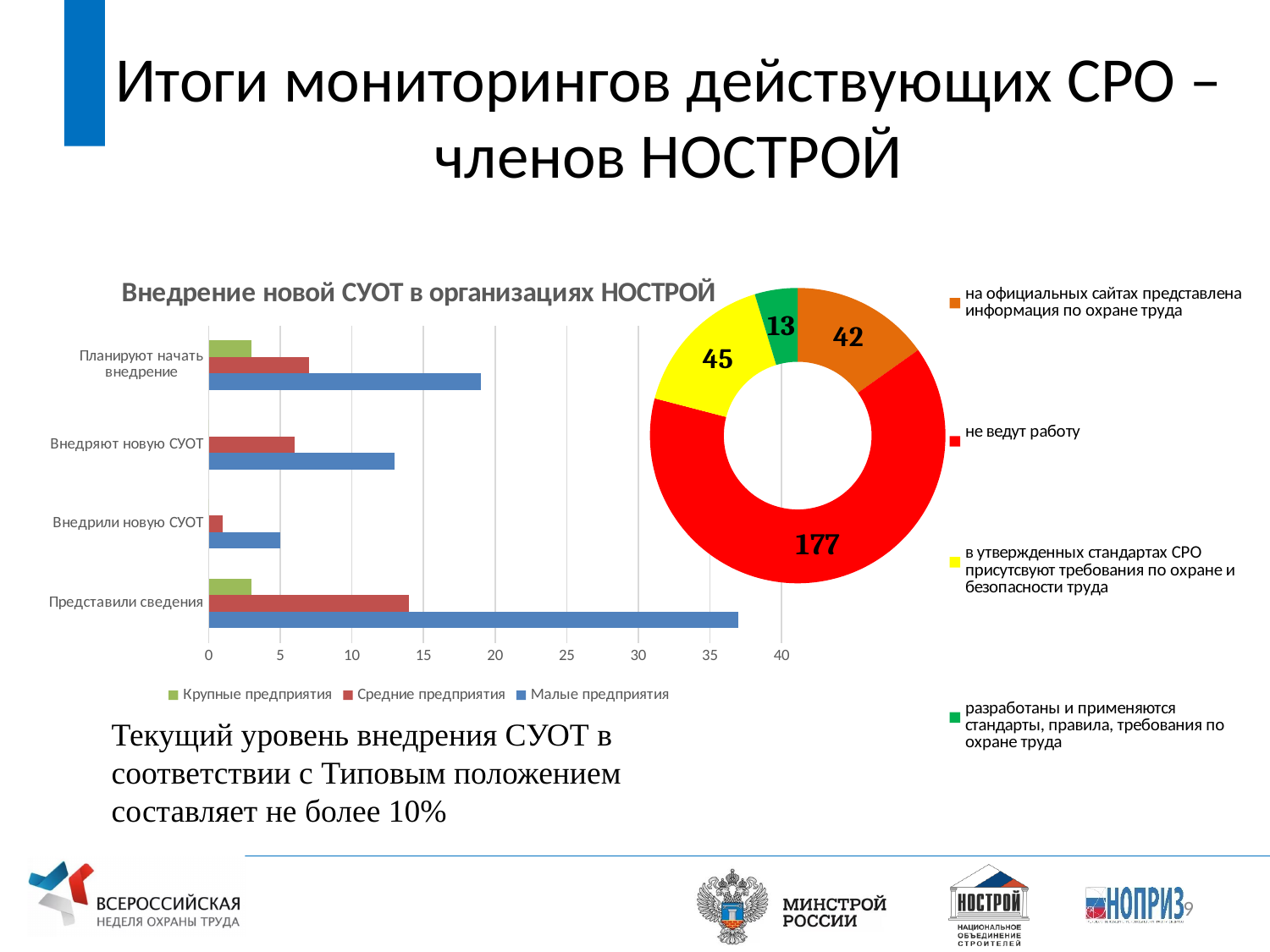
In the doughnut chart on the right, what is the difference between the value for "в утвержденных стандартах СРО присутсвуют требования по охране и безопасности труда" and the value for "на официальных сайтах представлена информация по охране труда"? 3 In the doughnut chart on the right, what is the total of all four segments? 277 In the doughnut chart on the right, what is the value for "не ведут работу"? 177 In the chart "Внедрение новой СУОТ в организациях НОСТРОЙ", which is larger for the category "Планируют начать внедрение": "Малые предприятия" or "Средние предприятия"? Малые предприятия What kind of chart is the chart on the right of the slide with the values 42, 177, 45 and 13? Doughnut chart In the chart "Внедрение новой СУОТ в организациях НОСТРОЙ", is the value for "Малые предприятия" in the category "Представили сведения" greater or less than 35? greater What kind of chart is the chart titled "Внедрение новой СУОТ в организациях НОСТРОЙ"? Bar chart In the doughnut chart on the right, which category has the largest value? не ведут работу How many series does the legend of the chart "Внедрение новой СУОТ в организациях НОСТРОЙ" list? 3 In the doughnut chart on the right, which category has the smallest value? разработаны и применяются стандарты, правила, требования по охране труда How many categories are shown on the vertical axis of the chart "Внедрение новой СУОТ в организациях НОСТРОЙ"? 4 In the doughnut chart on the right, what is the value for "на официальных сайтах представлена информация по охране труда"? 42